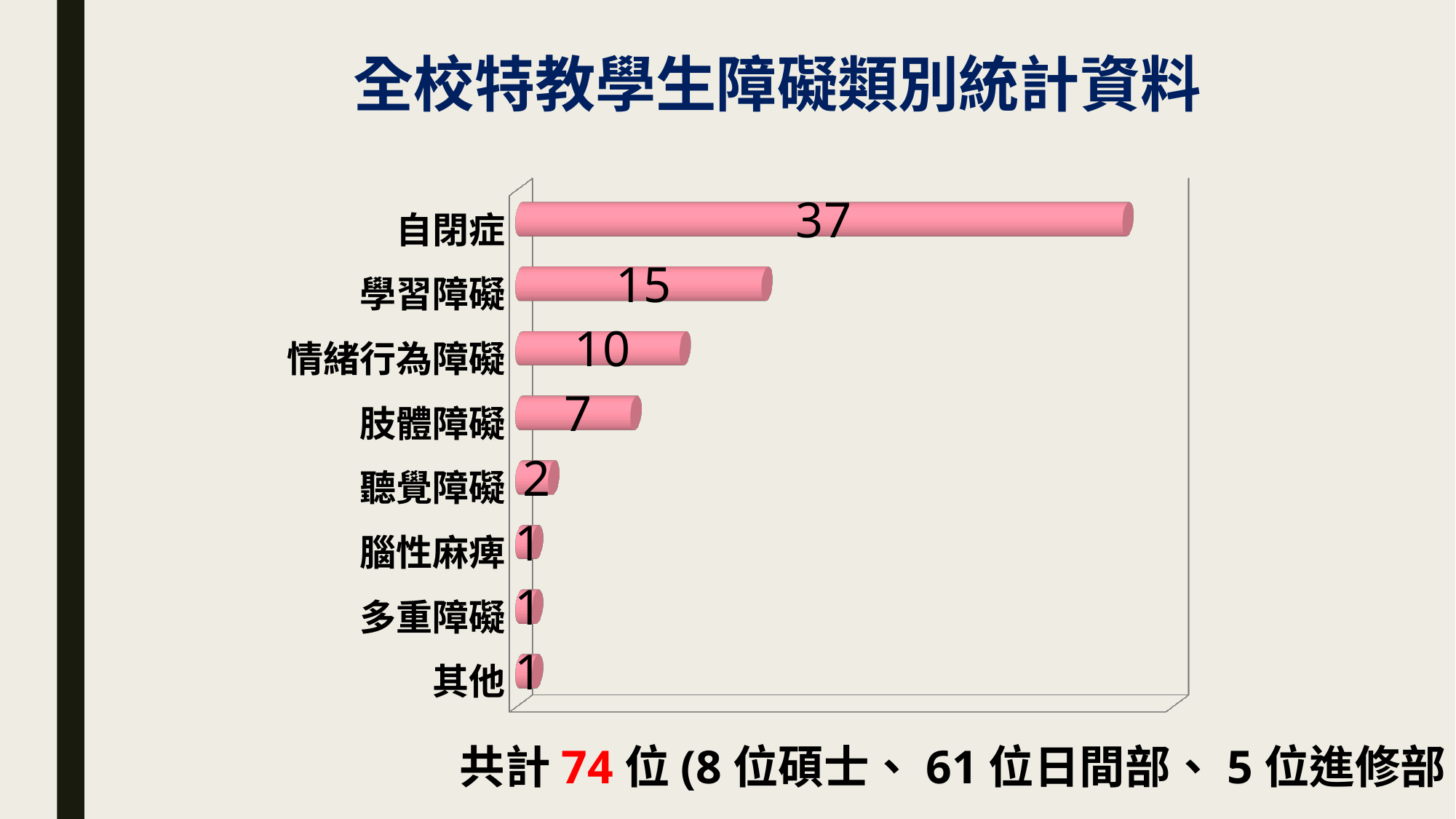
What is the value for 肢體障礙? 7 How many categories are shown in the chart? 8 What is the value for 自閉症? 37 What is the difference between the values for 情緒行為障礙 and 肢體障礙? 3 What is the title of the slide? 全校特教學生障礙類別統計資料 Which is larger, the value for 學習障礙 or the value for 情緒行為障礙? 學習障礙 What is the value for 聽覺障礙? 2 What kind of chart is shown on the slide? bar chart What is the value for 情緒行為障礙? 10 What is the difference between the values for 自閉症 and 學習障礙? 22 What is the value for 學習障礙? 15 Which category has the highest value? 自閉症